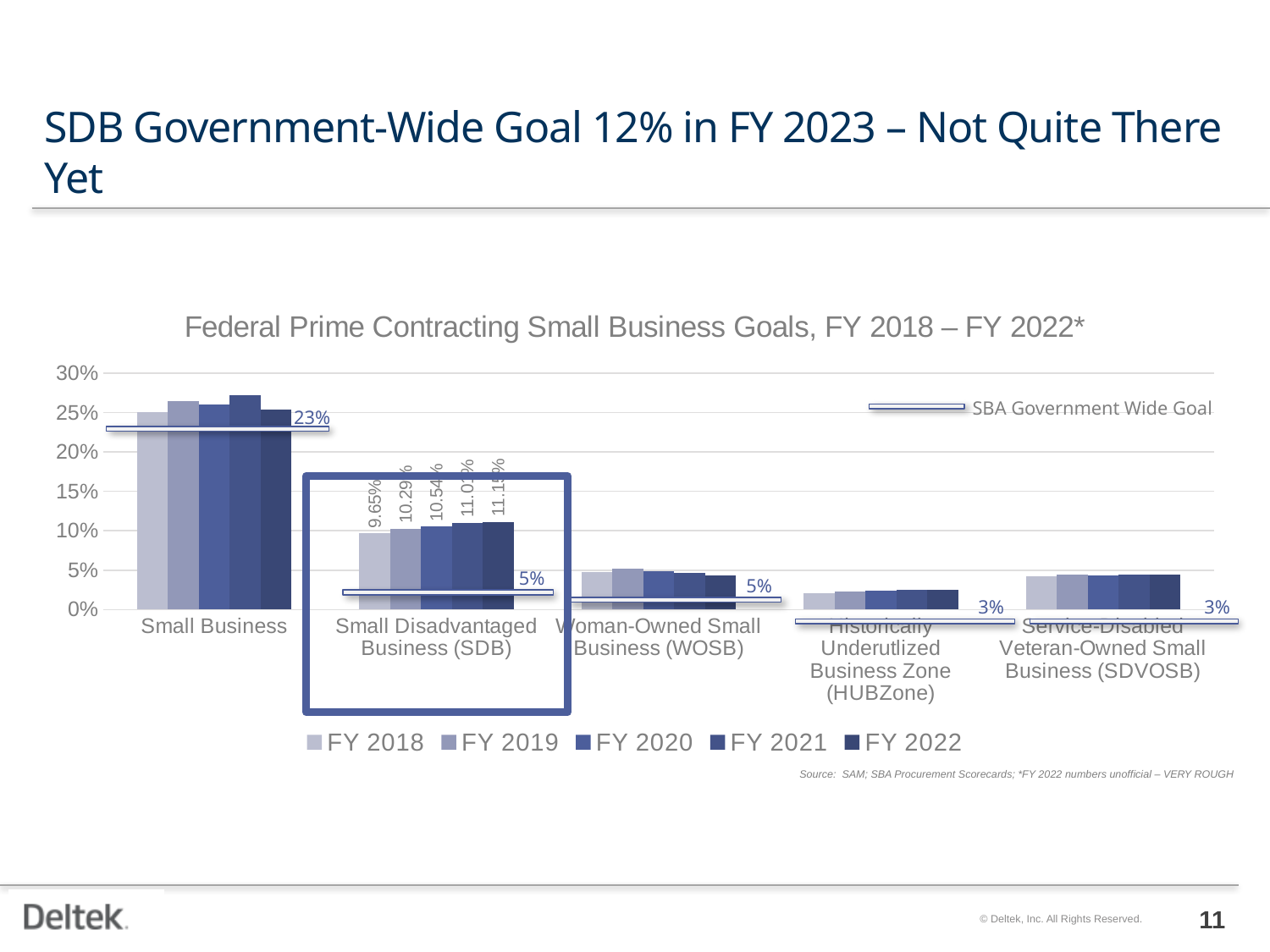
What is the FY 2018 value for Small Disadvantaged Business (SDB)? 9.65% What is the SBA Government Wide Goal shown for Historically Underutilized Business Zone (HUBZone)? 3% Is the FY 2018 value for Small Business greater or less than 20%? greater How many business categories are shown along the x axis? 5 Do the values for Small Disadvantaged Business (SDB) rise or fall from FY 2018 to FY 2022? rise What is the FY 2020 value for Small Disadvantaged Business (SDB)? 10.54% Which business category has the highest values across all fiscal years? Small Business What kind of chart is shown on the slide? bar chart Which business category has the lowest values across all fiscal years? Historically Underutilized Business Zone (HUBZone) What is the title of the chart? Federal Prime Contracting Small Business Goals, FY 2018 – FY 2022* What is the SBA Government Wide Goal shown for Small Business? 23% How many fiscal year series does the legend at the bottom of the chart list? 5